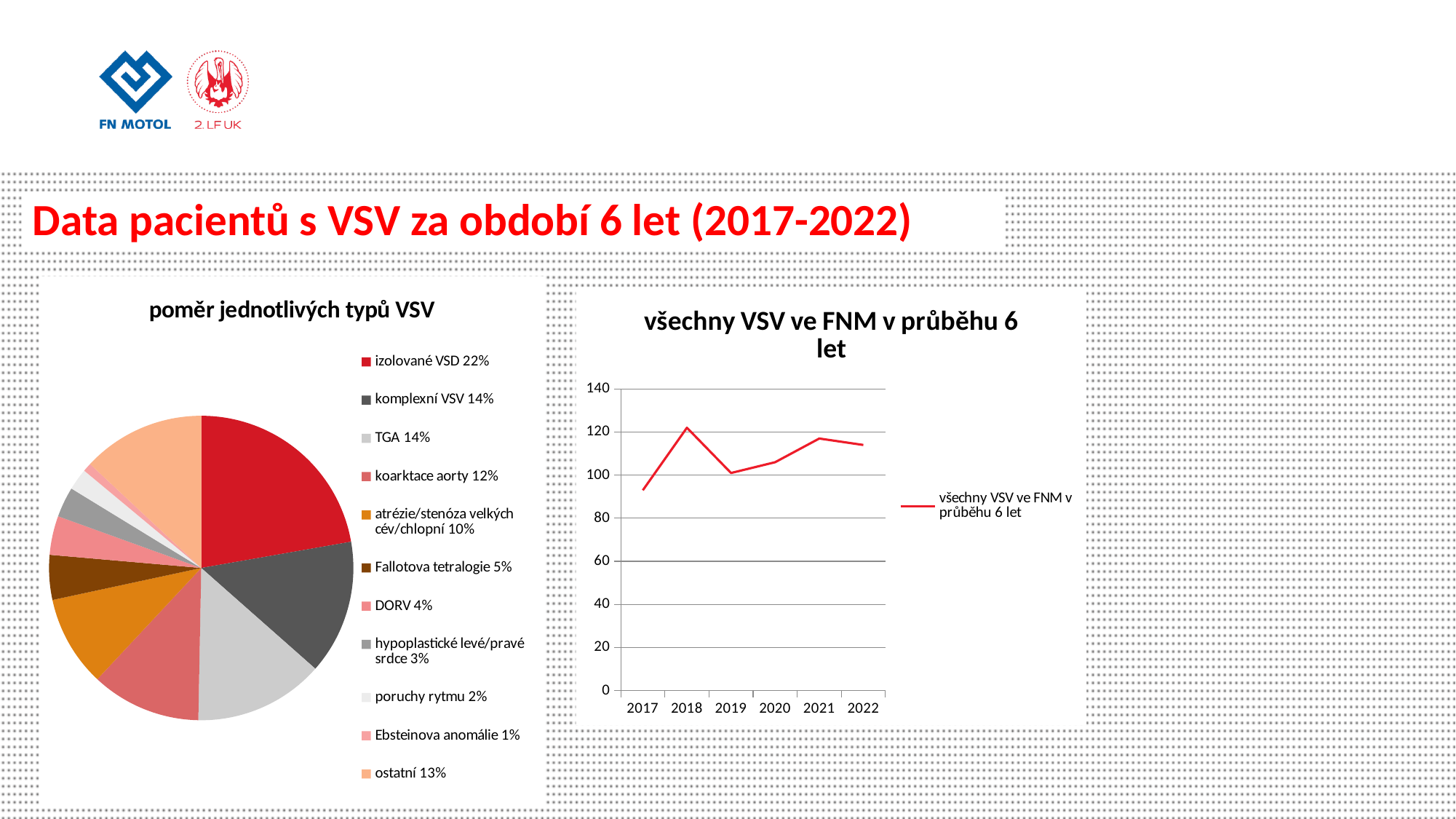
In the chart 'všechny VSV ve FNM v průběhu 6 let', which year has the lowest value? 2017 In the pie chart 'poměr jednotlivých typů VSV', what share does koarktace aorty have? 12% In the chart 'všechny VSV ve FNM v průběhu 6 let', how many series does the legend list? 1 In the pie chart 'poměr jednotlivých typů VSV', how many categories does the legend list? 11 In the chart 'všechny VSV ve FNM v průběhu 6 let', which year has the highest value? 2018 In the pie chart 'poměr jednotlivých typů VSV', which category has the smallest share? Ebsteinova anomálie What kind of chart is 'všechny VSV ve FNM v průběhu 6 let'? line chart In the pie chart 'poměr jednotlivých typů VSV', which category has the largest share? izolované VSD In the pie chart 'poměr jednotlivých typů VSV', what is the difference in share between izolované VSD and komplexní VSV? 8% In the pie chart 'poměr jednotlivých typů VSV', what share does izolované VSD have? 22% In the chart 'všechny VSV ve FNM v průběhu 6 let', is the value for 2017 greater or less than 100? less